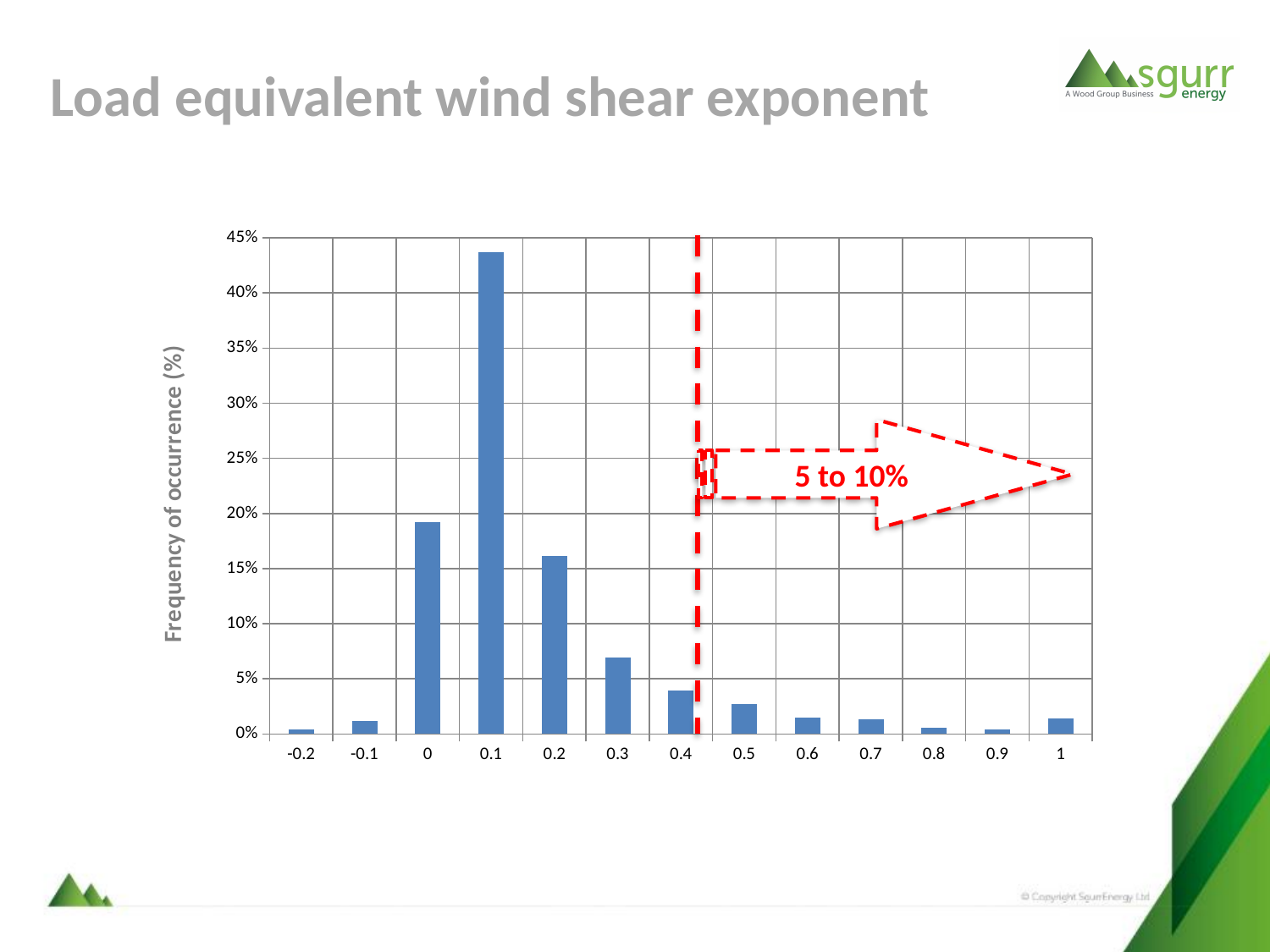
Which has the higher frequency of occurrence, 0.3 or 0.5? 0.3 How many categories are shown on the x axis of the chart? 13 Is the value for 0.3 greater or less than 5%? greater Is the value for 0.4 greater or less than 5%? less Is the value for 0.1 greater or less than 40%? greater Which x-axis category has the highest frequency of occurrence? 0.1 Do the values rise or fall along the x axis from 0.1 to 0.9? fall What is the label on the y axis of the chart? Frequency of occurrence (%) What kind of chart is shown on the slide? bar chart Which has the higher frequency of occurrence, 0 or 0.2? 0